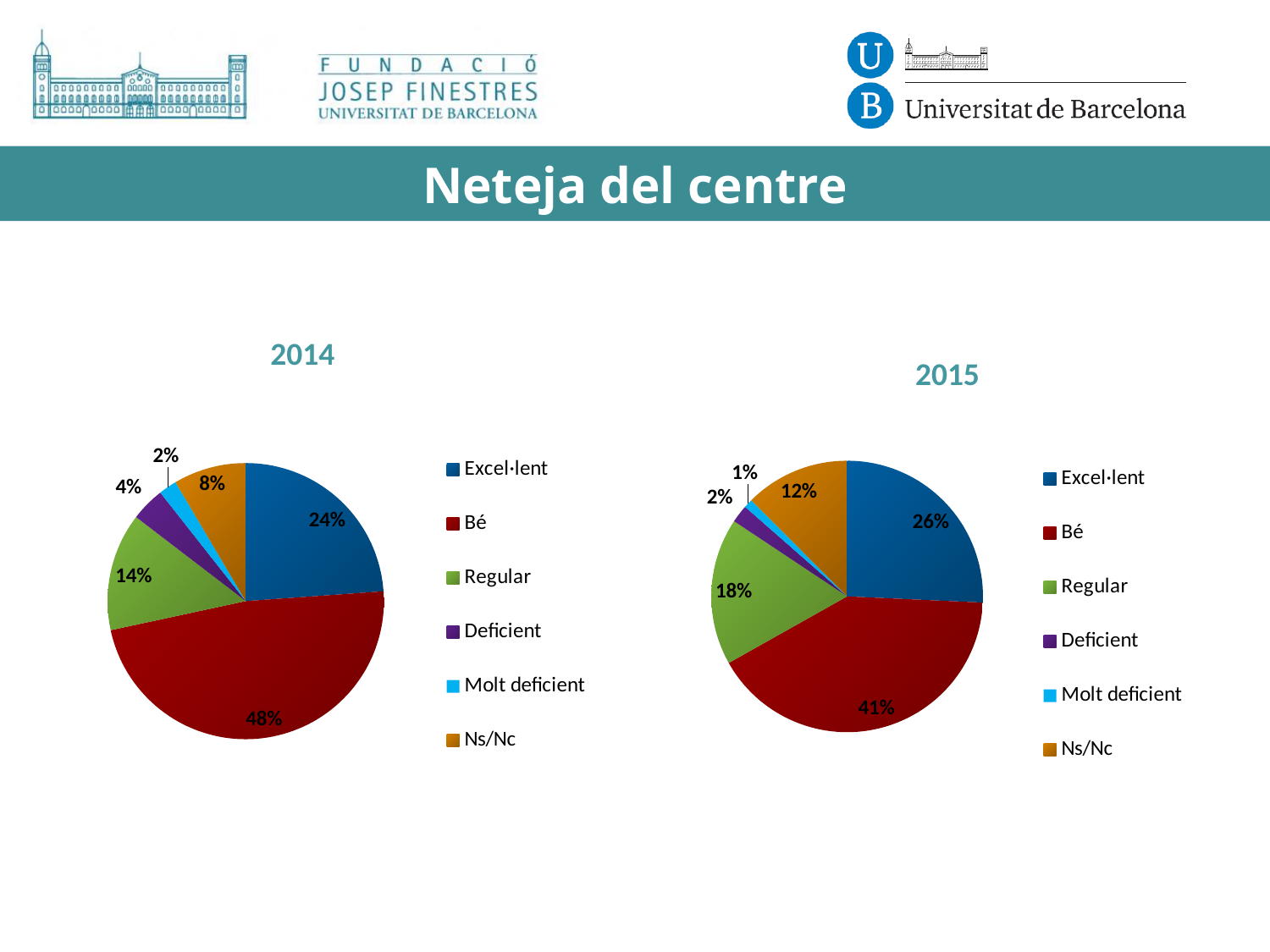
How many categories does the legend of the 2015 pie chart list? 6 In the 2014 pie chart, which is larger, Regular or Ns/Nc? Regular In the 2014 pie chart, what share does Deficient have? 4% In the 2015 pie chart, which category has the smallest slice? Molt deficient In the 2014 pie chart, what share does Bé have? 48% What kind of chart is the 2014 chart? Pie chart In the 2015 pie chart, what is the difference between the Bé and Excel·lent shares? 15% What colour is the Bé slice in the 2015 pie chart? Red In the 2014 pie chart, what share does Ns/Nc have? 8% In the 2015 pie chart, what share does Regular have? 18% In the 2014 pie chart, which category has the largest slice? Bé In the 2015 pie chart, what share does Excel·lent have? 26%